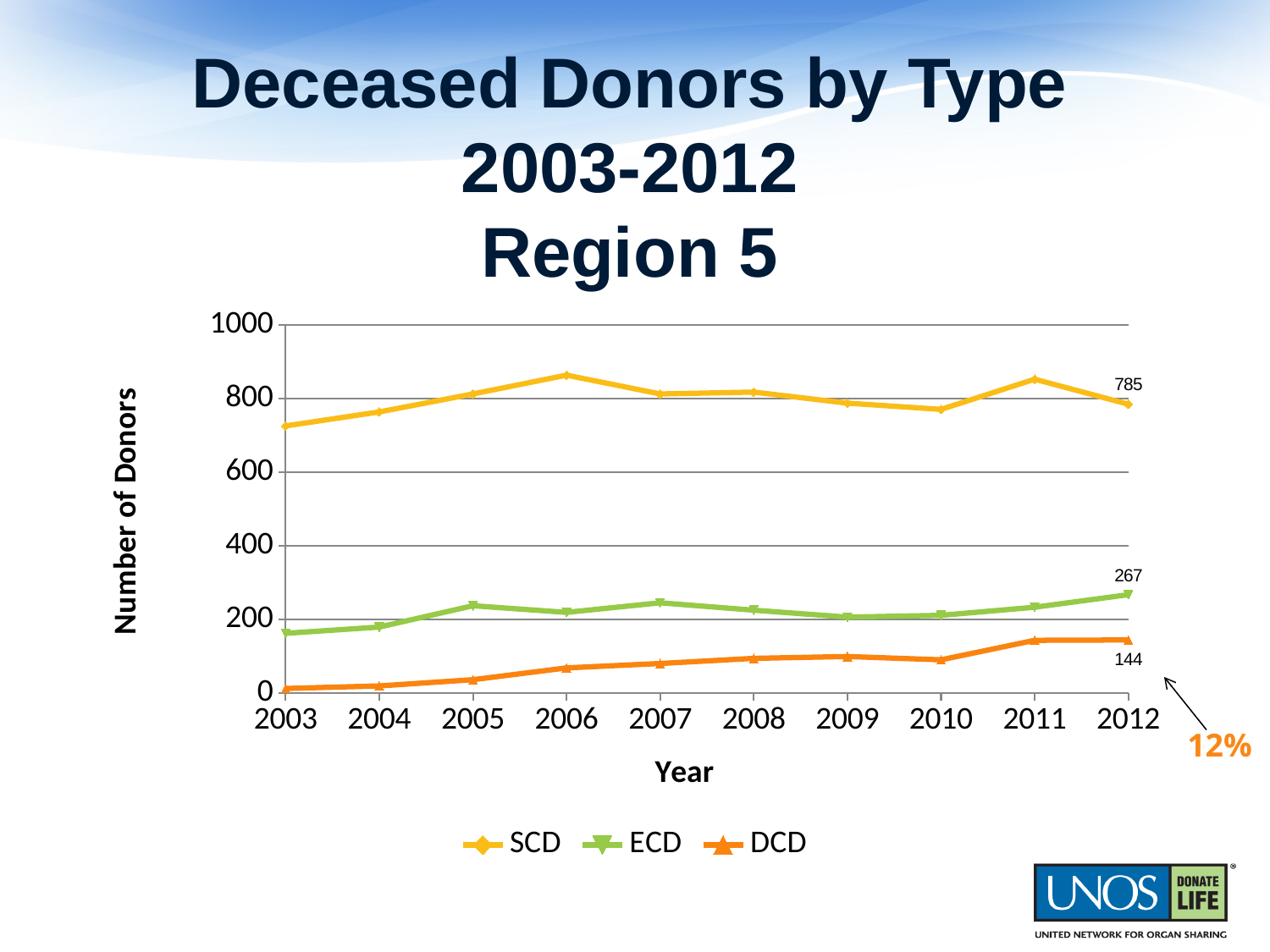
Is the value for DCD in 2003 greater or less than 200? less What is the value for DCD in 2012? 144 Is the value for SCD in 2006 greater or less than 800? greater Which series has the lowest value in 2012? DCD Which is larger in 2012, ECD or DCD? ECD How many series does the legend list? 3 How many years are shown on the x axis? 10 What is the value for SCD in 2012? 785 Which series has the highest value in 2012? SCD What is the difference between the SCD and ECD values in 2012? 518 What is the value for ECD in 2012? 267 What kind of chart is shown on the slide? line chart